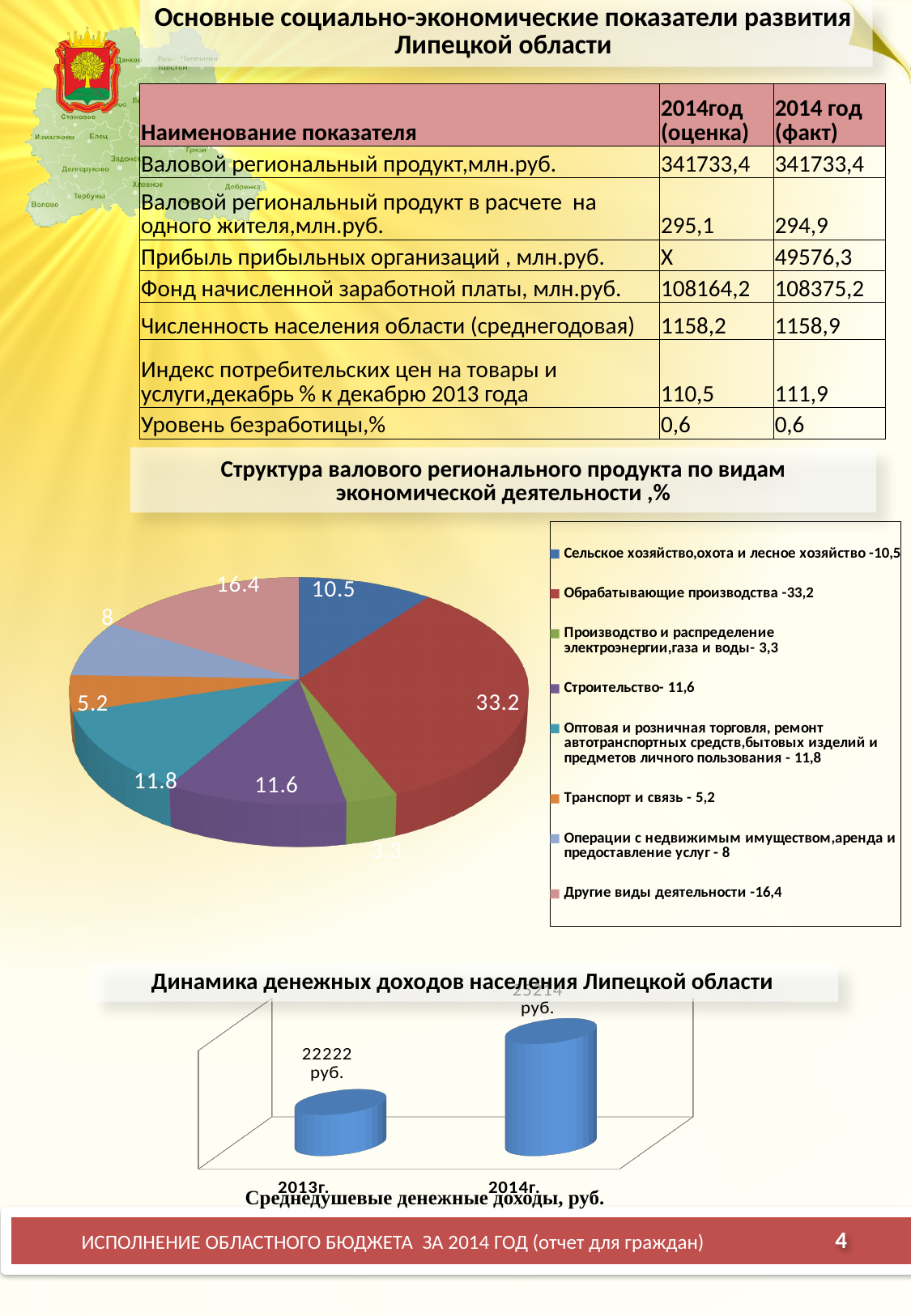
In the pie chart "Структура валового регионального продукта", what is the difference between Обрабатывающие производства and Сельское хозяйство, охота и лесное хозяйство? 22.7 In the pie chart "Структура валового регионального продукта", what is the value for Строительство? 11.6 In the chart "Динамика денежных доходов населения Липецкой области", which year has the larger value, 2013г. or 2014г.? 2014г. What kind of chart is the chart titled "Динамика денежных доходов населения Липецкой области"? bar chart How many categories does the legend of the pie chart "Структура валового регионального продукта" list? 8 In the pie chart "Структура валового регионального продукта", which is larger: Транспорт и связь or Операции с недвижимым имуществом, аренда и предоставление услуг? Операции с недвижимым имуществом, аренда и предоставление услуг In the pie chart "Структура валового регионального продукта", which category has the largest share? Обрабатывающие производства In the chart "Динамика денежных доходов населения Липецкой области", what is the value for 2013г.? 22222 руб. In the pie chart "Структура валового регионального продукта", which category has the smallest share? Производство и распределение электроэнергии, газа и воды In the pie chart "Структура валового регионального продукта", what is the value for Обрабатывающие производства? 33.2 In the pie chart "Структура валового регионального продукта", what is the value for Другие виды деятельности? 16.4 What kind of chart is the chart titled "Структура валового регионального продукта по видам экономической деятельности, %"? pie chart